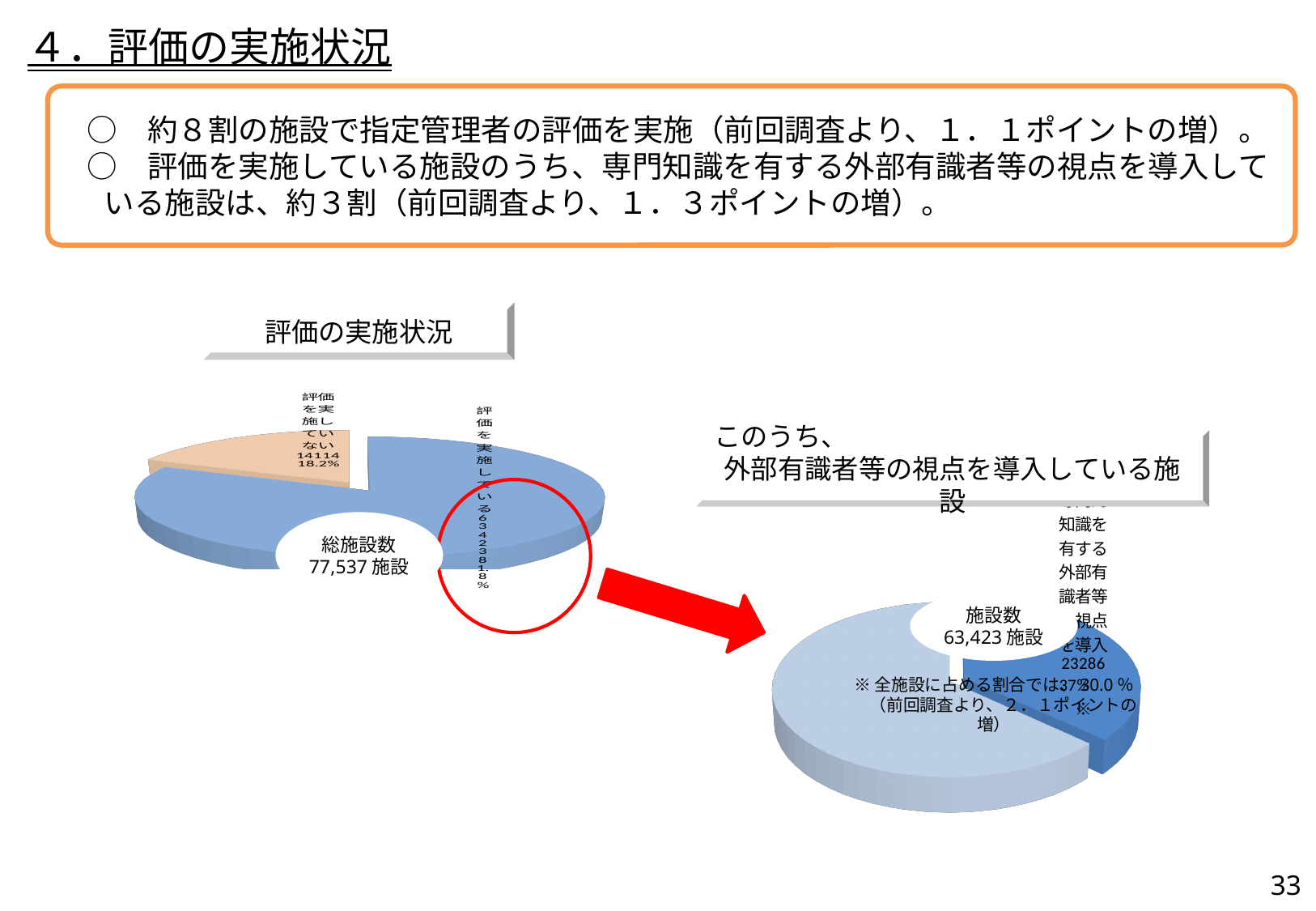
In the right chart, how many facilities are in the slice for 専門知識を有する外部有識者等の視点を導入? 23286 In the left chart 評価の実施状況, how many slices does the pie have? 2 In the left chart 評価の実施状況, what share of the pie is 評価を実施していない? 18.2% In the left chart 評価の実施状況, what share of the pie is 評価を実施している? 81.8% What is the title of the left chart? 評価の実施状況 What kind of chart is the left chart titled 評価の実施状況? pie chart In the left chart 評価の実施状況, how many facilities are in the 評価を実施していない slice? 14114 In the right chart, what number of facilities is shown in the centre of the pie? 63,423 施設 In the right chart, is the slice for 専門知識を有する外部有識者等の視点を導入 larger or smaller than the other slice? smaller In the left chart 評価の実施状況, what is the total number of facilities shown in the centre of the pie? 77,537 施設 In the left chart 評価の実施状況, which slice is larger, 評価を実施している or 評価を実施していない? 評価を実施している In the left chart 評価の実施状況, how many more facilities are in 評価を実施している (63423) than in 評価を実施していない (14114)? 49309